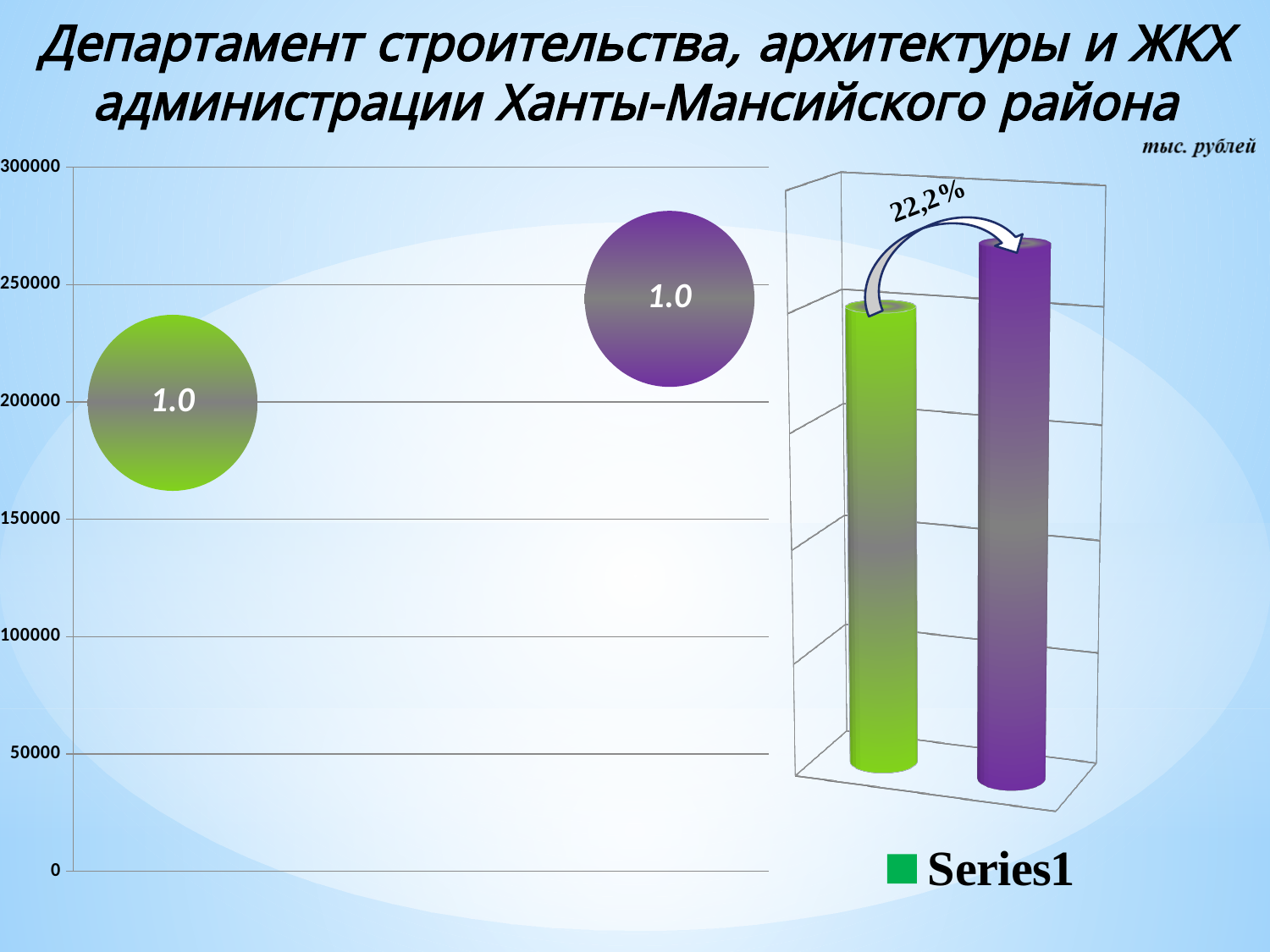
What percentage change is written on the arrow between the two bars? 22,2% What is the name of the series shown in the legend? Series1 What is the highest value shown on the vertical axis? 300000 What kind of chart is shown on the slide? a bubble chart and a 3D bar chart What unit is indicated above the chart? тыс. рублей How many series does the chart legend list? 1 Which bar is taller, the green bar or the purple bar? the purple bar How many bars are plotted in the chart? 2